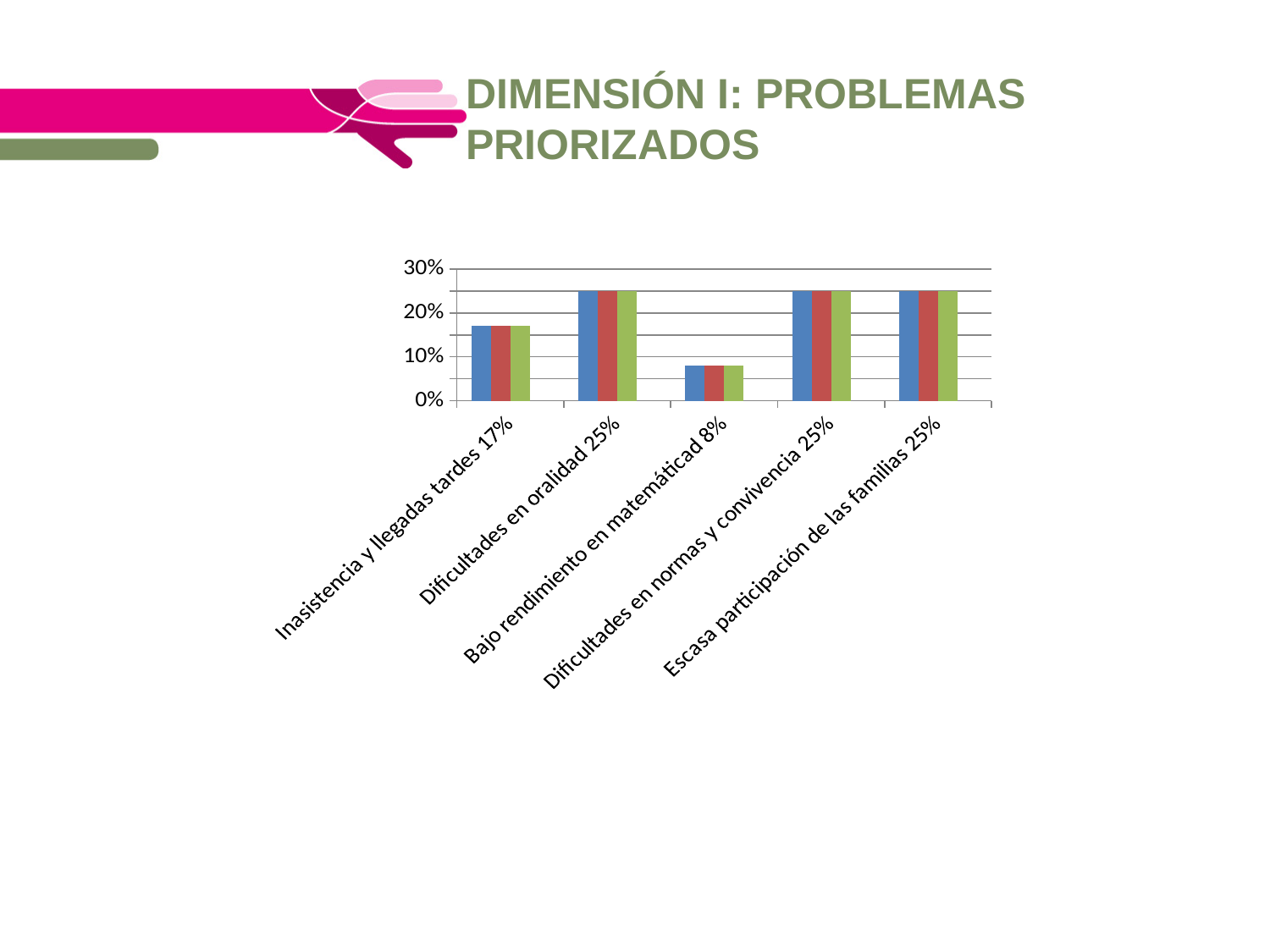
What is the difference between the value for 'Escasa participación de las familias' and the value for 'Inasistencia y llegadas tardes'? 8% What percentage is shown for 'Dificultades en oralidad'? 25% How many categories are shown on the x axis of the chart? 5 What type of chart is shown on the slide? bar chart Which is larger: the value for 'Inasistencia y llegadas tardes' or the value for 'Bajo rendimiento en matemática'? Inasistencia y llegadas tardes Which category has the lowest value in the chart? Bajo rendimiento en matemática Is the value for 'Dificultades en normas y convivencia' greater or less than 20%? greater What is the title of the slide containing the chart? DIMENSIÓN I: PROBLEMAS PRIORIZADOS Is the value for 'Bajo rendimiento en matemática' greater or less than 10%? less What is the difference between the value for 'Inasistencia y llegadas tardes' and the value for 'Bajo rendimiento en matemática'? 9% What percentage is shown for 'Inasistencia y llegadas tardes'? 17% What percentage is shown for 'Bajo rendimiento en matemática'? 8%